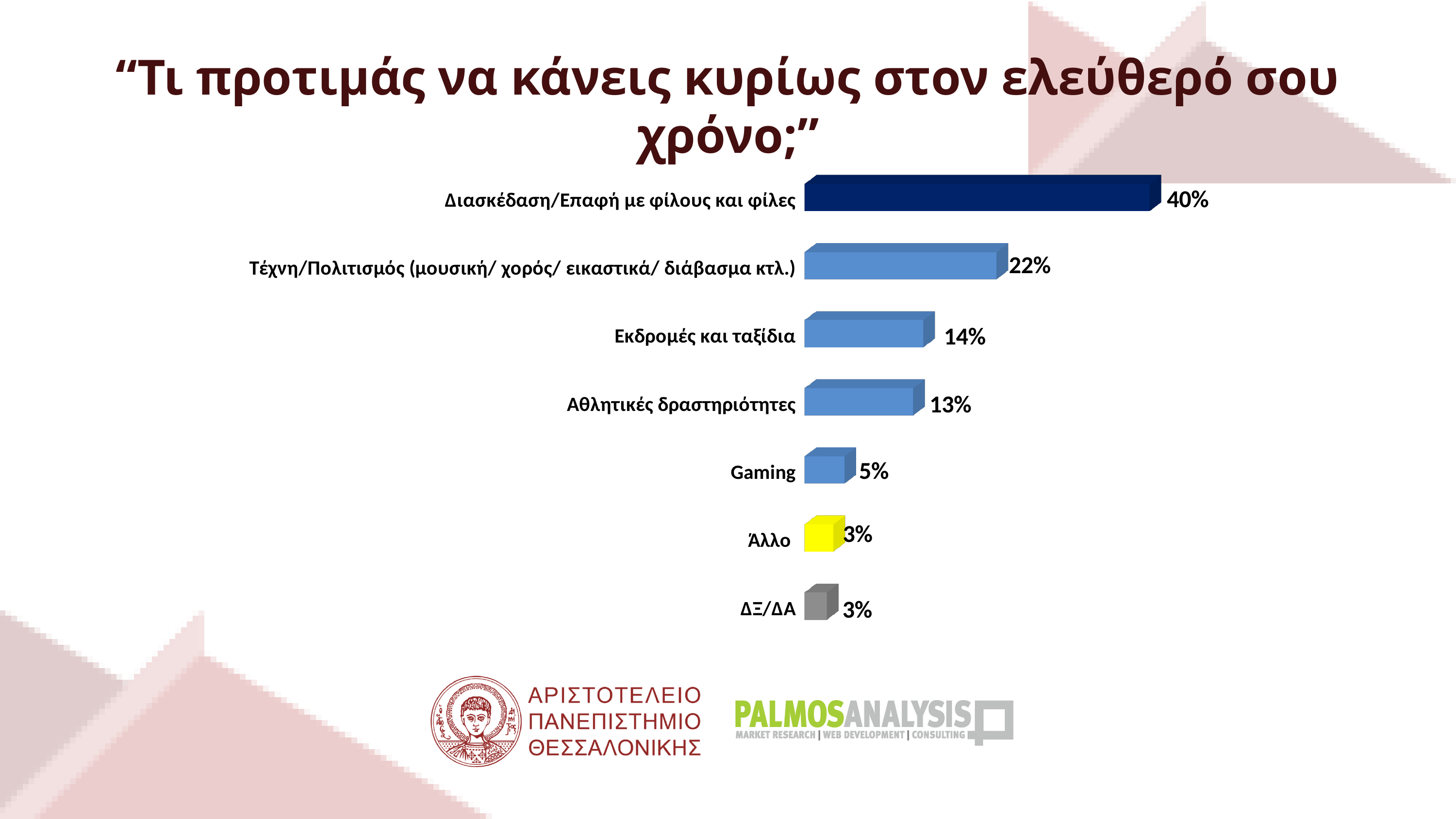
What is the value for ΔΞ/ΔΑ? 3% What colour is the bar for Άλλο? Yellow Which category has the highest value? Διασκέδαση/Επαφή με φίλους και φίλες How many categories are shown in the chart? 7 What is the difference between the values for Εκδρομές και ταξίδια and Gaming? 9% What is the value for Διασκέδαση/Επαφή με φίλους και φίλες? 40% What is the value for Gaming? 5% What kind of chart is shown on the slide? Bar chart What is the value for Εκδρομές και ταξίδια? 14% What is the value for Τέχνη/Πολιτισμός (μουσική/ χορός/ εικαστικά/ διάβασμα κτλ.)? 22% What is the difference between the values for Διασκέδαση/Επαφή με φίλους και φίλες and Τέχνη/Πολιτισμός (μουσική/ χορός/ εικαστικά/ διάβασμα κτλ.)? 18% Which is larger, the value for Αθλητικές δραστηριότητες or the value for Gaming? Αθλητικές δραστηριότητες